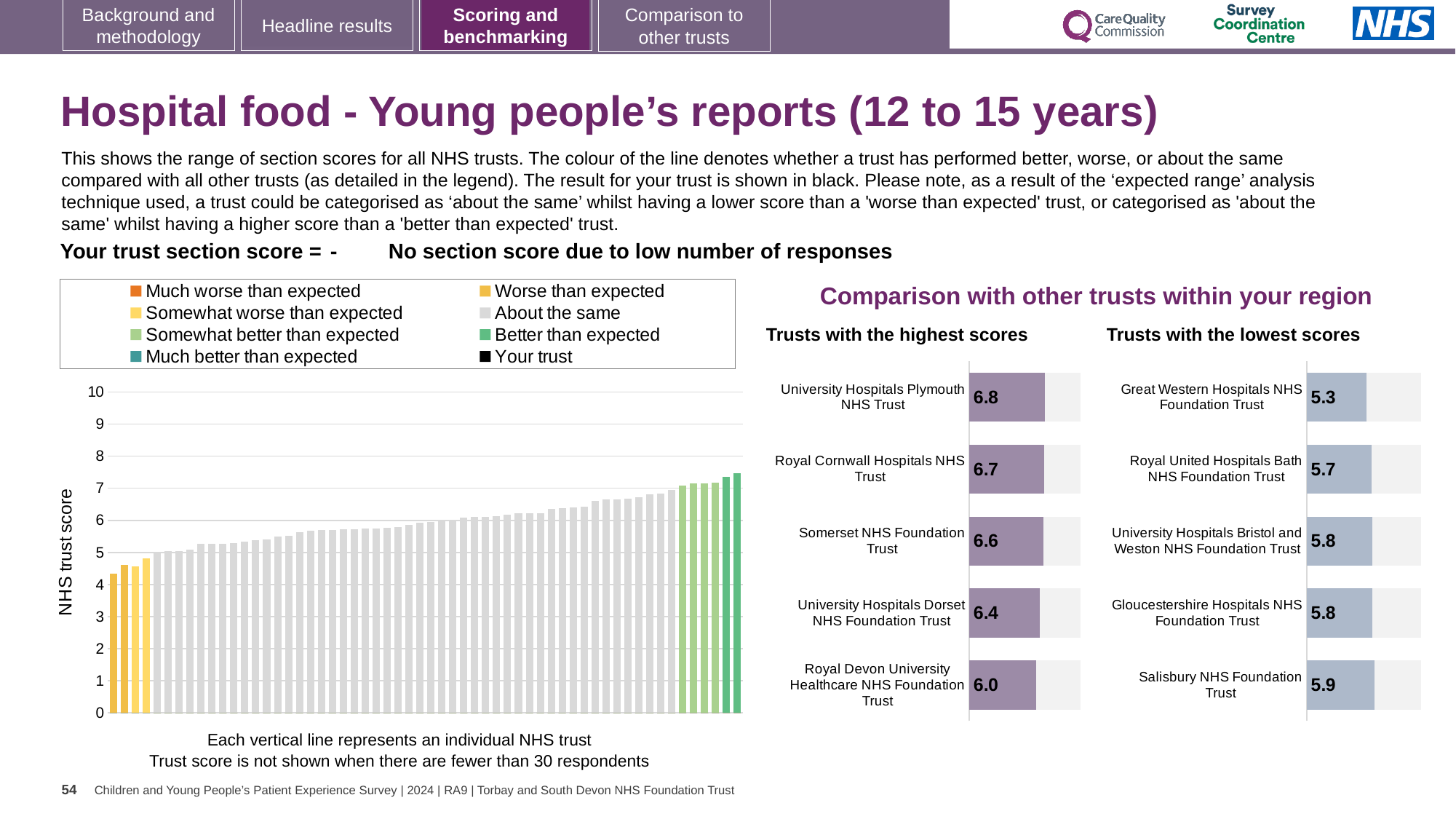
What kind of chart is the 'NHS trust score' chart on the left of the slide? bar chart In the 'Trusts with the highest scores' chart, which trust has the highest score? University Hospitals Plymouth NHS Trust In the 'Trusts with the lowest scores' chart, what is the difference between the scores of Salisbury NHS Foundation Trust and Great Western Hospitals NHS Foundation Trust? 0.6 In the 'Trusts with the highest scores' chart, what is the difference between the scores of University Hospitals Plymouth NHS Trust and Royal Devon University Healthcare NHS Foundation Trust? 0.8 In the 'NHS trust score' chart on the left, is the value of the leftmost bar greater or less than 5? less In the 'Trusts with the lowest scores' chart, which trust has the lowest score? Great Western Hospitals NHS Foundation Trust In the 'Trusts with the lowest scores' chart, what is the score for Royal United Hospitals Bath NHS Foundation Trust? 5.7 In the 'NHS trust score' chart on the left, do the bar values rise or fall from left to right? rise How many entries does the legend above the 'NHS trust score' chart list? 8 Comparing the regional charts, which has the higher score: University Hospitals Dorset NHS Foundation Trust or Salisbury NHS Foundation Trust? University Hospitals Dorset NHS Foundation Trust In the 'Trusts with the highest scores' chart, what is the score for Somerset NHS Foundation Trust? 6.6 How many trusts are listed in the 'Trusts with the highest scores' chart? 5